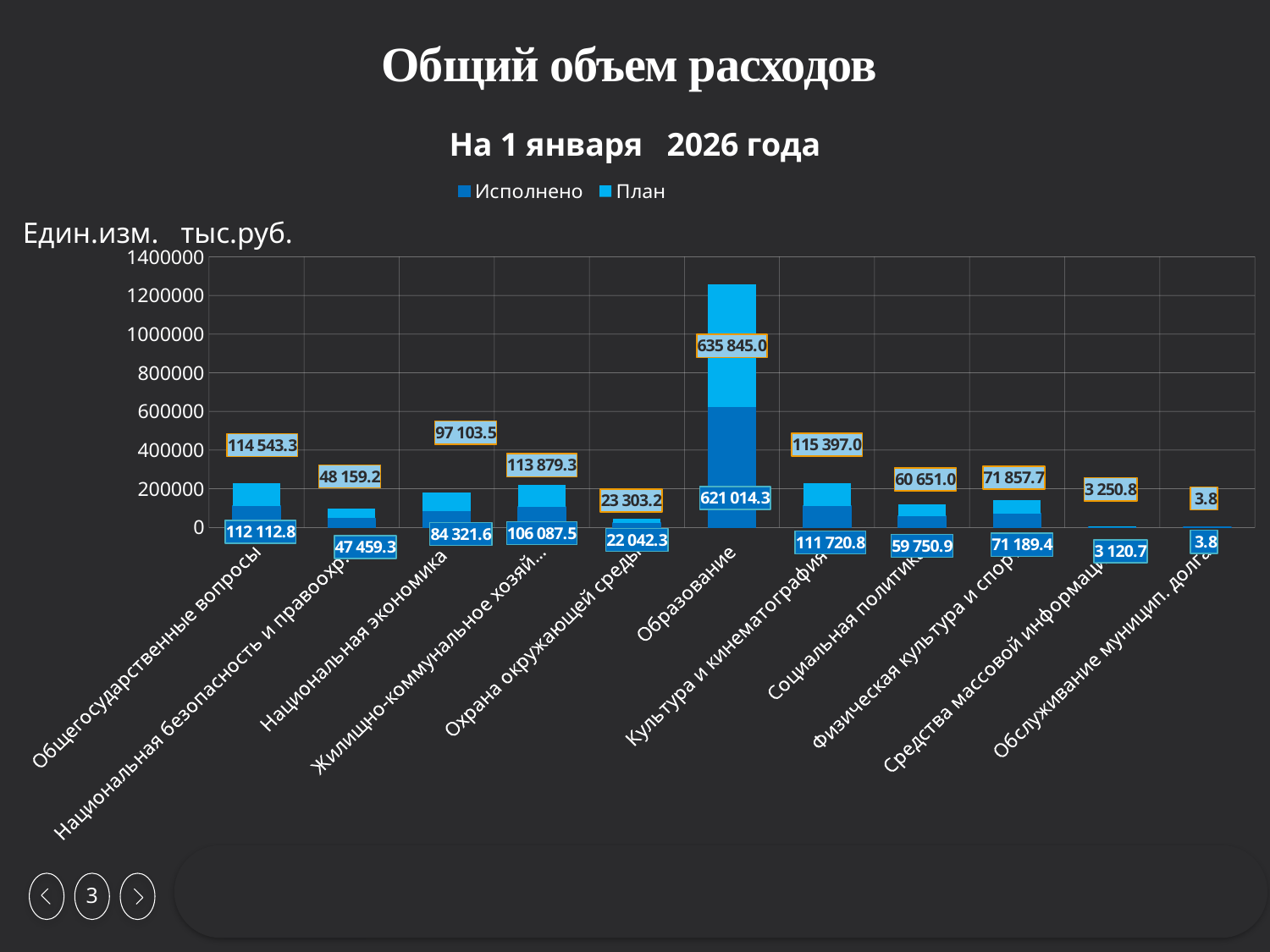
What is the Исполнено value for Образование? 621 014.3 What is the План value for Культура и кинематография? 115 397.0 Is the total stacked bar for Образование greater or less than 1200000? greater Which is larger, the Исполнено value for Общегосударственные вопросы or the Исполнено value for Национальная экономика? Общегосударственные вопросы Which category has the highest Исполнено value? Образование How many categories are shown on the x axis? 11 What is the total of the stacked bar for Общегосударственные вопросы? 226 656.1 What is the План value for Национальная экономика? 97 103.5 Which category has the lowest План value? Обслуживание муницип. долга What is the Исполнено value for Охрана окружающей среды? 22 042.3 How many series does the legend list? 2 What is the difference between the План and Исполнено values for Образование? 14 830.7